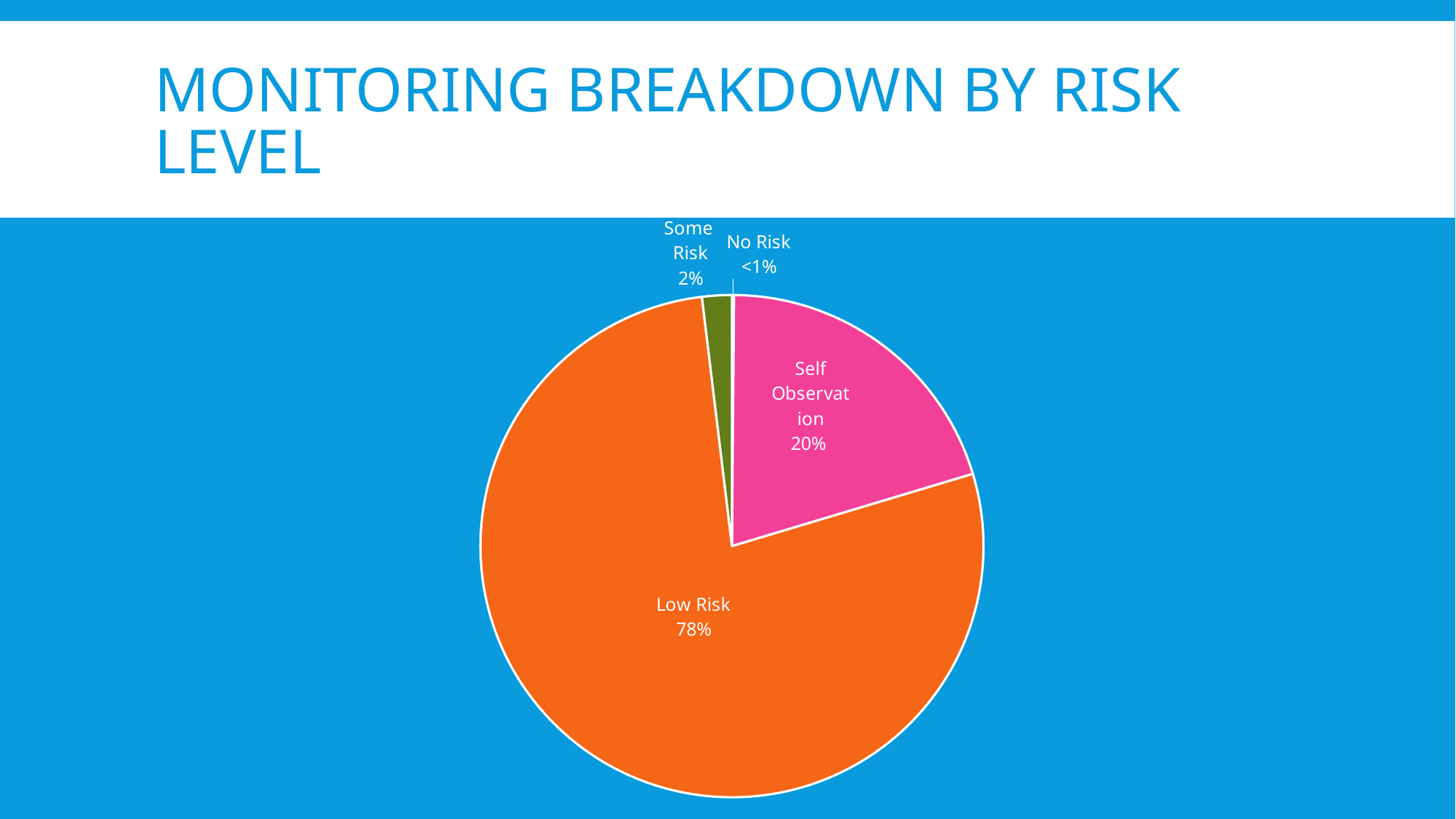
Which is larger, the Self Observation slice or the Some Risk slice? Self Observation What is the difference between the Low Risk and Self Observation shares? 58% What is the title of the slide containing the pie chart? Monitoring Breakdown by Risk Level What share of the pie does Self Observation represent? 20% What share of the pie does Some Risk represent? 2% What kind of chart is shown on the slide? pie chart What share of the pie does Low Risk represent? 78% What value is shown for the No Risk slice? <1% Which category has the smallest slice of the pie? No Risk Which category has the largest slice of the pie? Low Risk How many slices does the pie chart have? 4 What colour is the Low Risk slice? orange